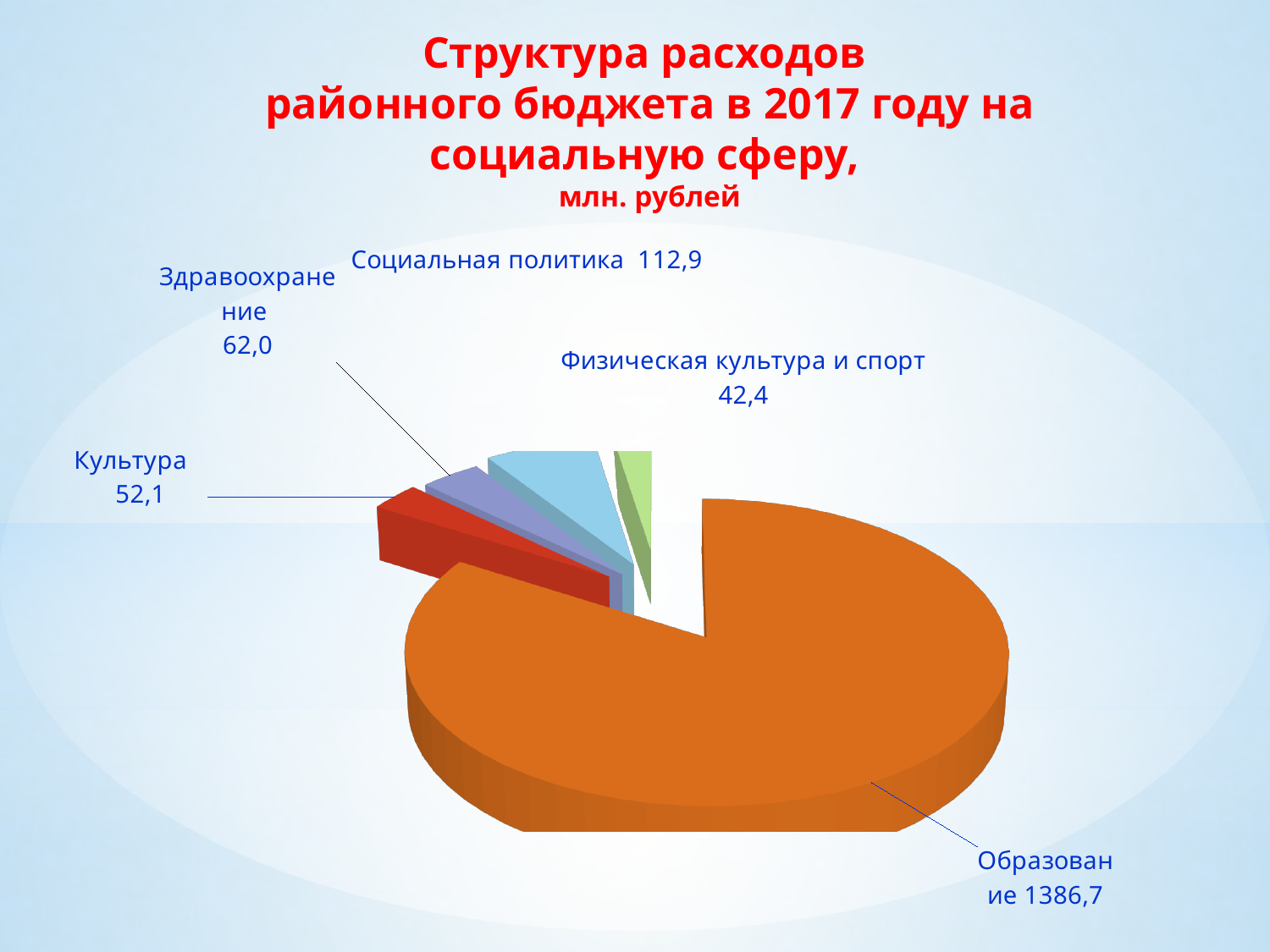
What type of chart is shown on the slide? pie chart What is the value for Физическая культура и спорт? 42,4 Which is larger, Культура or Физическая культура и спорт? Культура Which category has the largest slice of the pie? Образование What is the value for Социальная политика? 112,9 How many categories are shown in the pie chart? 5 What is the value for Образование? 1386,7 Which category has the smallest slice of the pie? Физическая культура и спорт What is the value for Культура? 52,1 In what units are the values on the chart given, according to the title? млн. рублей What is the difference between Социальная политика and Здравоохранение? 50,9 What is the value for Здравоохранение? 62,0